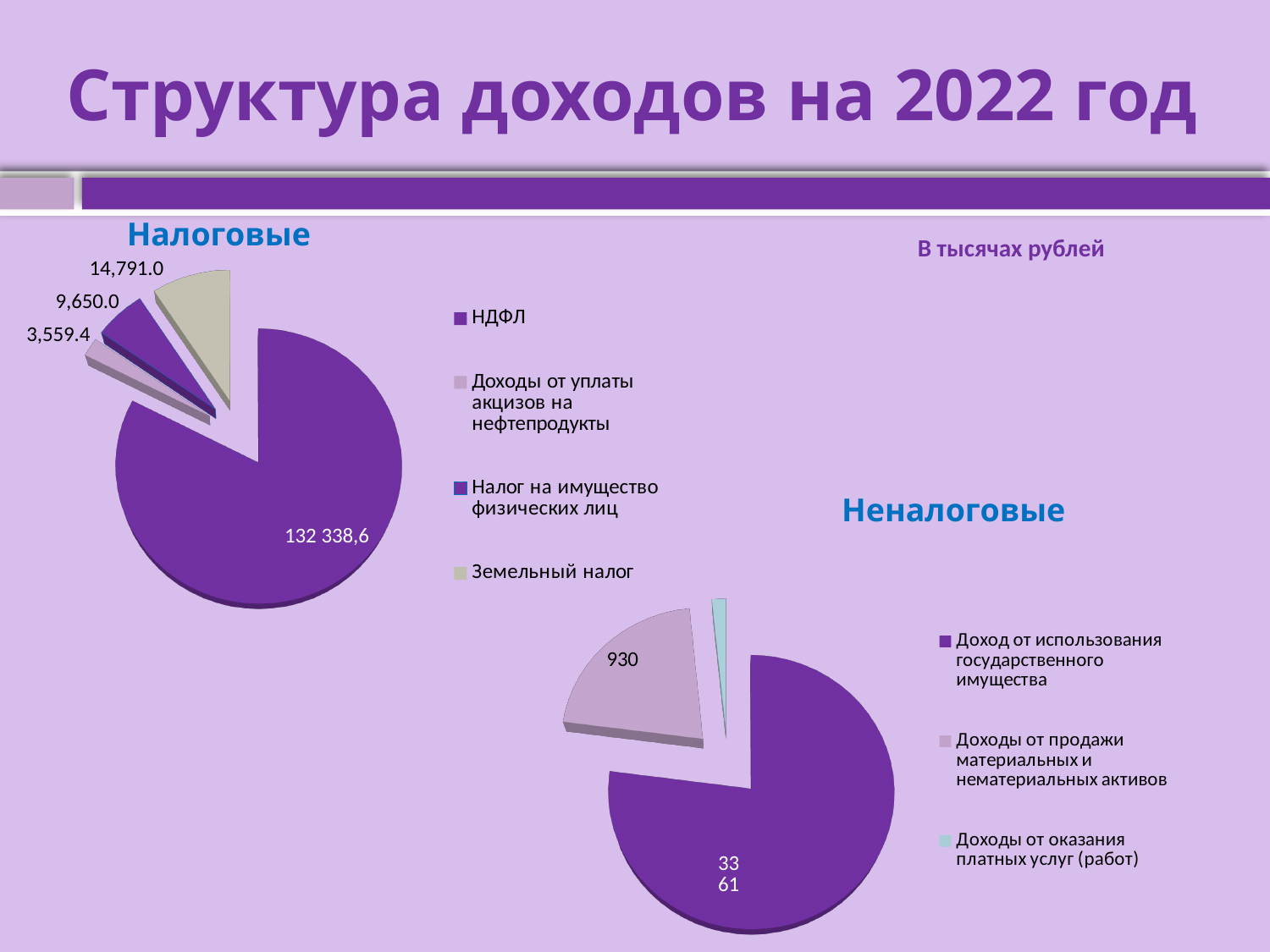
In the "Налоговые" chart, which category has the smallest slice? Доходы от уплаты акцизов на нефтепродукты In what units are the values on the slide given? В тысячах рублей In the "Налоговые" chart, what is the difference between Земельный налог and Налог на имущество физических лиц? 5,141.0 In the "Неналоговые" chart, what is the value for Доходы от продажи материальных и нематериальных активов? 930 In the "Налоговые" chart, what is the value for Налог на имущество физических лиц? 9,650.0 In the "Налоговые" chart, what is the value for Земельный налог? 14,791.0 In the "Неналоговые" chart, which category has the smallest slice? Доходы от оказания платных услуг (работ) In the "Налоговые" chart, what is the value for НДФЛ? 132 338,6 What kind of chart is the "Налоговые" chart? pie chart In the "Налоговые" chart, which category has the largest slice? НДФЛ In the "Налоговые" chart, what is the value for Доходы от уплаты акцизов на нефтепродукты? 3,559.4 How many categories does the "Налоговые" chart show? 4